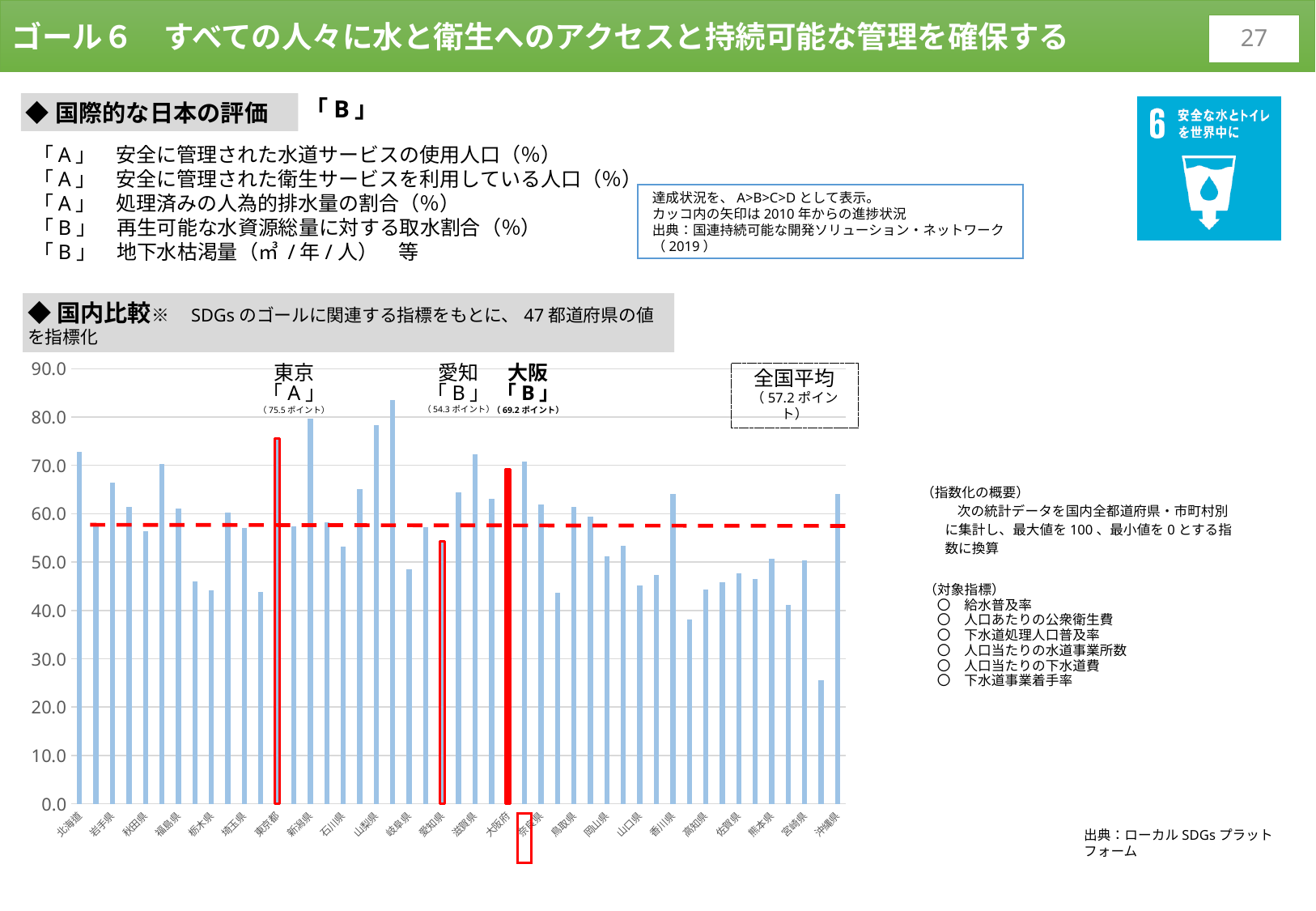
Is the value for 北海道 greater or less than 70? greater What is the difference between the values for 大阪 and 愛知? 14.9 ポイント What is the value for 東京 (Tokyo) shown on the chart? 75.5 ポイント What does the red dashed horizontal line on the chart represent? 全国平均 What is the value for 大阪 (Osaka) shown on the chart? 69.2 ポイント What is the value for 愛知 (Aichi) shown on the chart? 54.3 ポイント Is the value for 山梨県 greater or less than 70? greater What is the 全国平均 (national average) value shown on the chart? 57.2 ポイント What kind of chart is shown on the slide? bar chart What is the difference between the values for 東京 and 大阪? 6.3 ポイント Which has the larger value, 愛知 or the 全国平均? 全国平均